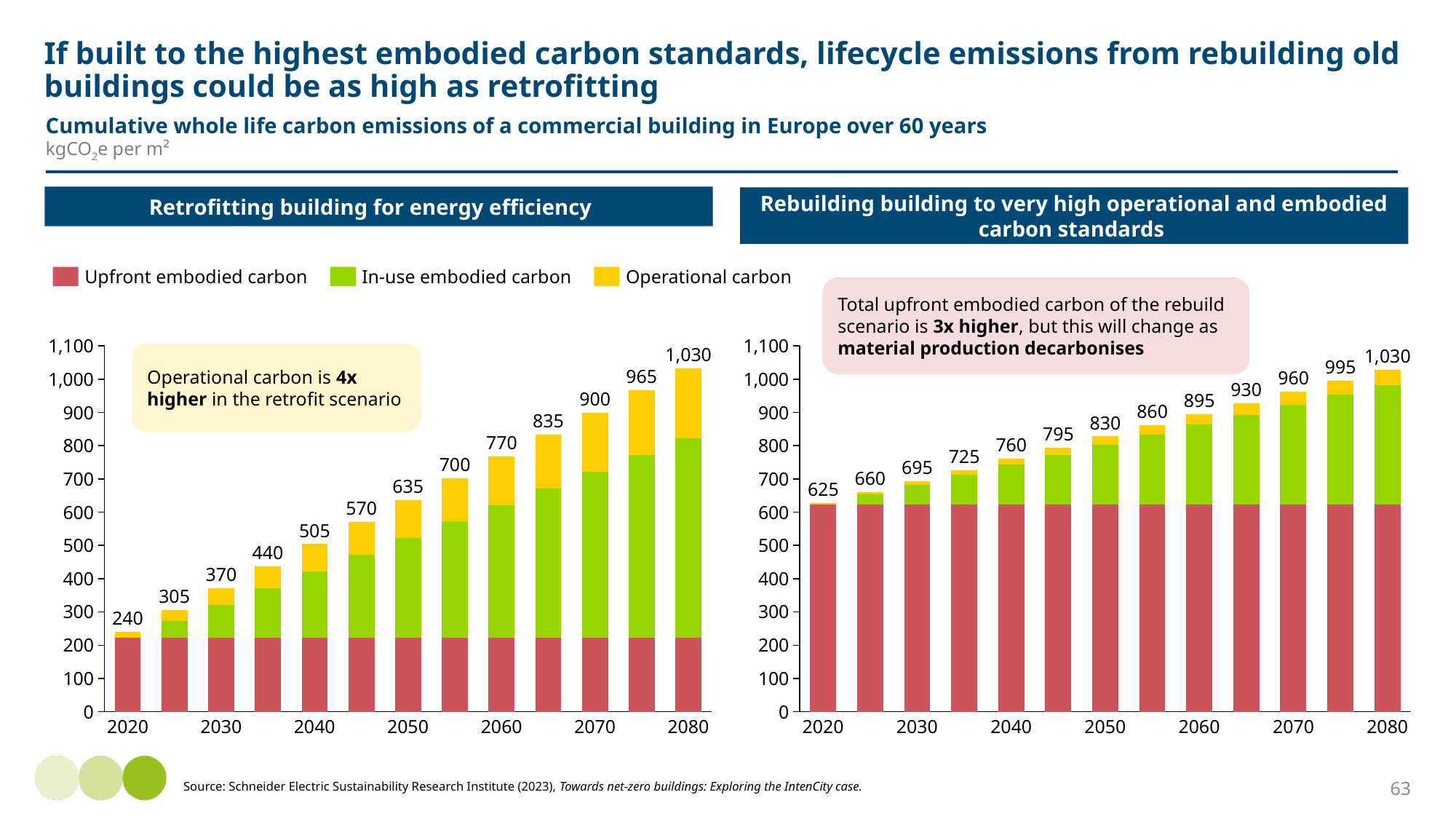
What kind of chart is used on the left for the retrofitting scenario? Stacked bar chart What is the difference between the 2020 total in the rebuilding chart (right) and the 2020 total in the retrofitting chart (left)? 385 How many series does the legend list for the charts? 3 In the retrofitting chart on the left, which year has the highest total? 2080 In the 'Rebuilding building to very high operational and embodied carbon standards' chart, what is the total value for 2020? 625 For 2040, which chart shows the larger total: the retrofitting chart on the left or the rebuilding chart on the right? The rebuilding chart on the right How many bars are plotted in the retrofitting chart on the left? 13 In the retrofitting chart on the left, what is the total value shown for 2080? 1,030 In the rebuilding chart on the right, what is the total value shown for 2050? 830 In the retrofitting chart on the left, is the upfront embodied carbon segment for 2020 greater or less than 300? less In the 'Retrofitting building for energy efficiency' chart, what is the total cumulative emissions value for 2020? 240 In the retrofitting chart on the left, what is the total value shown for 2050? 635